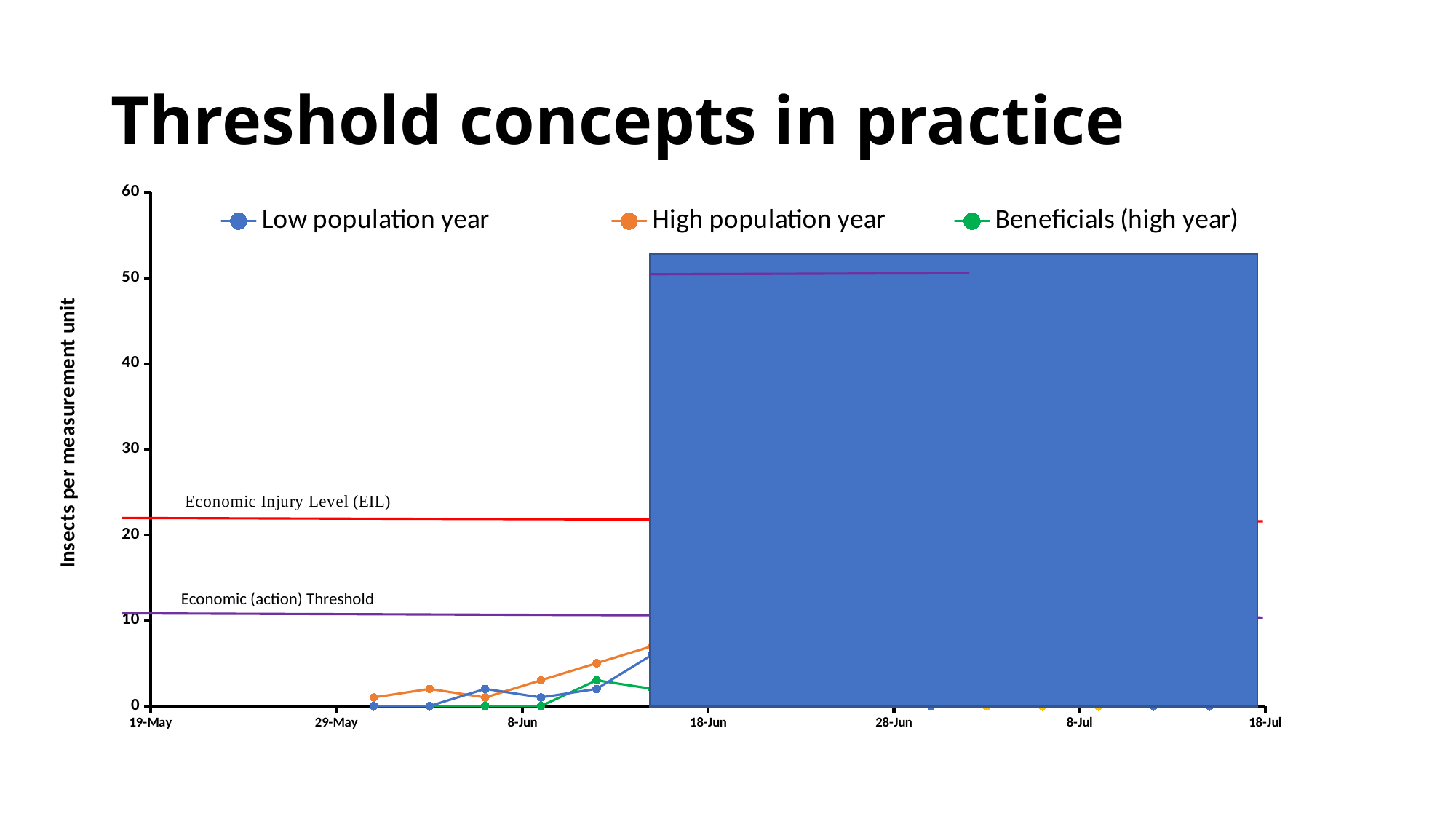
How many date labels are shown on the horizontal axis? 7 Is the red Economic Injury Level (EIL) line greater or less than 20 on the vertical axis? greater Is the highest visible value of the High population year series greater or less than 10? less What is the label of the vertical axis of the chart? Insects per measurement unit Is the purple Economic (action) Threshold line greater or less than 20 on the vertical axis? less Does the High population year series rise or fall between 29-May and mid-June? rise What kind of chart is shown on the slide? line chart What is the highest value shown on the vertical axis? 60 What is the value of the Beneficials (high year) series at 8-Jun? 0 How many series does the chart legend list? 3 Which series is higher at the last visible point before the blue box, Low population year or High population year? High population year What are the three series named in the chart legend? Low population year, High population year, Beneficials (high year)